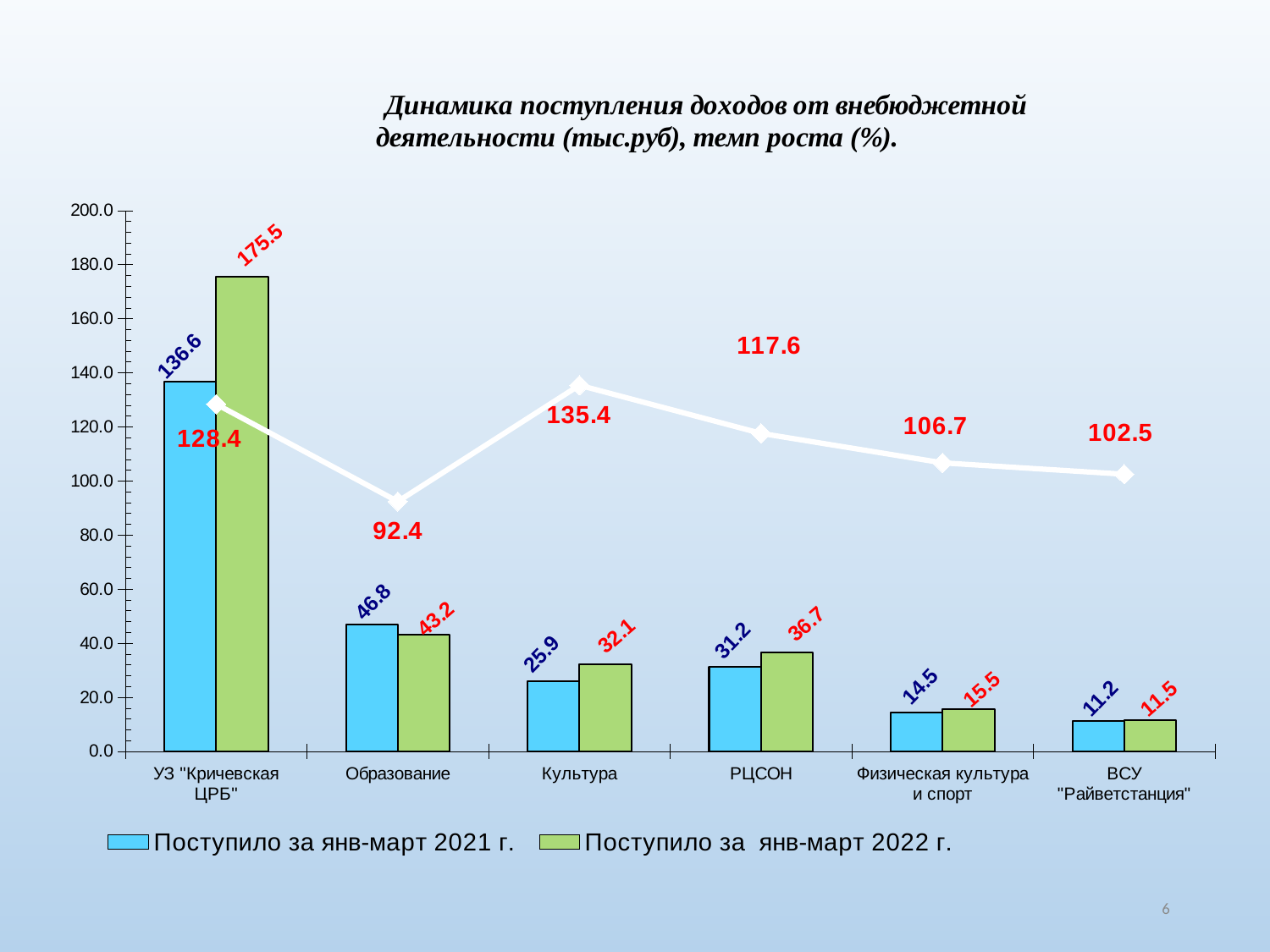
Which category has the highest value for "Поступило за янв-март 2022 г."? УЗ "Кричевская ЦРБ" How many categories are shown on the x axis? 6 What is the difference between the 2022 and 2021 values for УЗ "Кричевская ЦРБ"? 38.9 What colour are the bars for "Поступило за янв-март 2022 г."? Green What was the value of "Поступило за янв-март 2022 г." for УЗ "Кричевская ЦРБ"? 175.5 Which category has the lowest growth rate on the line? Образование What is the growth rate (темп роста) shown on the line for Культура? 135.4 What was the value of "Поступило за янв-март 2021 г." for Образование? 46.8 What kind of chart is this? Combined bar and line chart How many series does the legend list? 2 Which is larger for Образование: the value for янв-март 2021 г. or янв-март 2022 г.? Поступило за янв-март 2021 г. Which category has the lowest value for "Поступило за янв-март 2021 г."? ВСУ "Райветстанция"